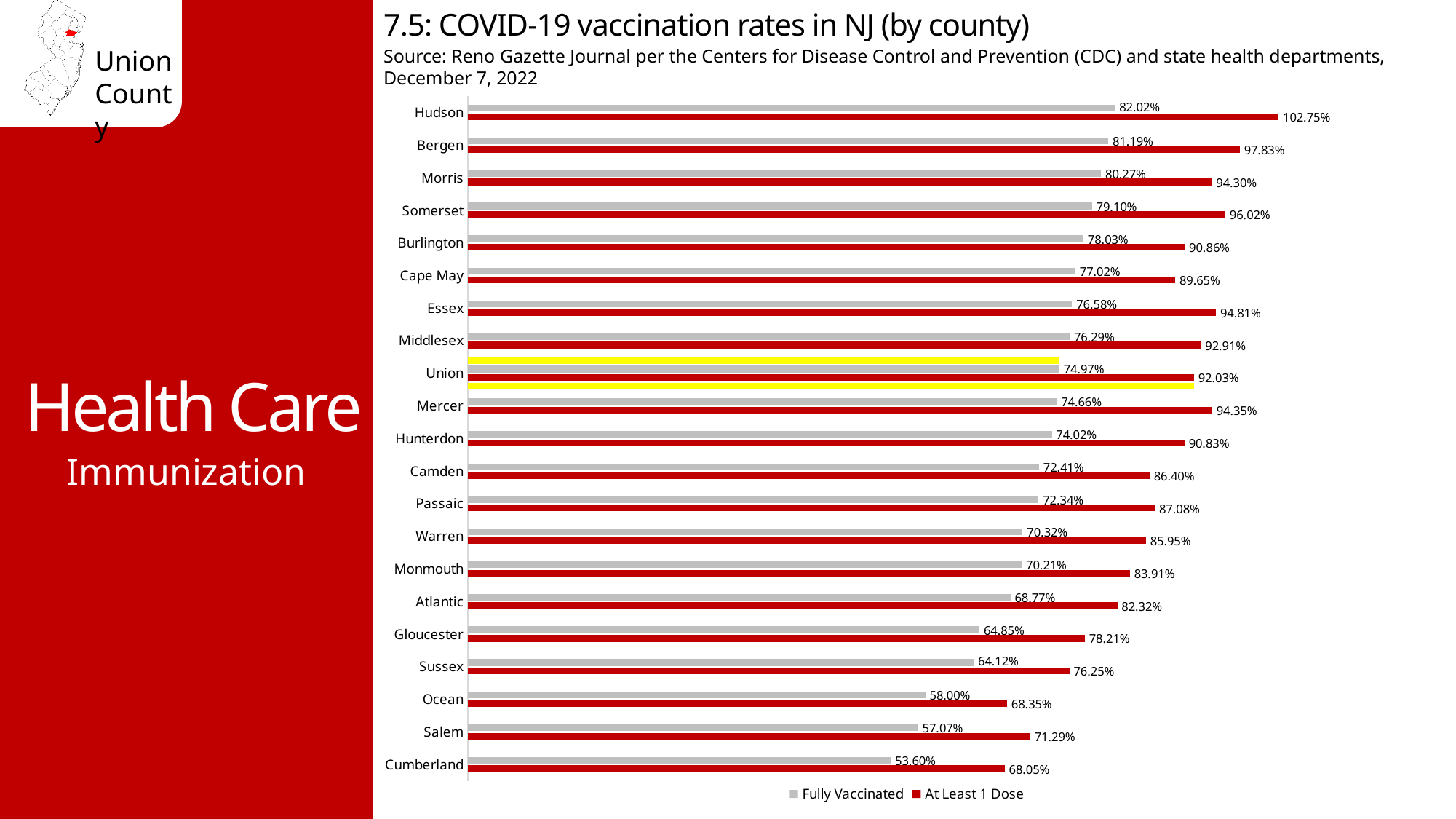
How many series does the legend list? 2 What is the At Least 1 Dose rate for Cumberland county? 68.05% How many counties are shown in the chart? 21 Which county has the highest Fully Vaccinated rate? Hudson What is the At Least 1 Dose rate for Hudson county? 102.75% What is the difference between the At Least 1 Dose rate and the Fully Vaccinated rate for Union county? 17.06 percentage points What is the Fully Vaccinated rate for Union county? 74.97% What is the Fully Vaccinated rate for Ocean county? 58.00% Which is larger: the At Least 1 Dose rate for Mercer or for Union? Mercer What kind of chart is shown on the slide? Bar chart Which county's bars are highlighted in yellow on the chart? Union Which county has the lowest Fully Vaccinated rate? Cumberland